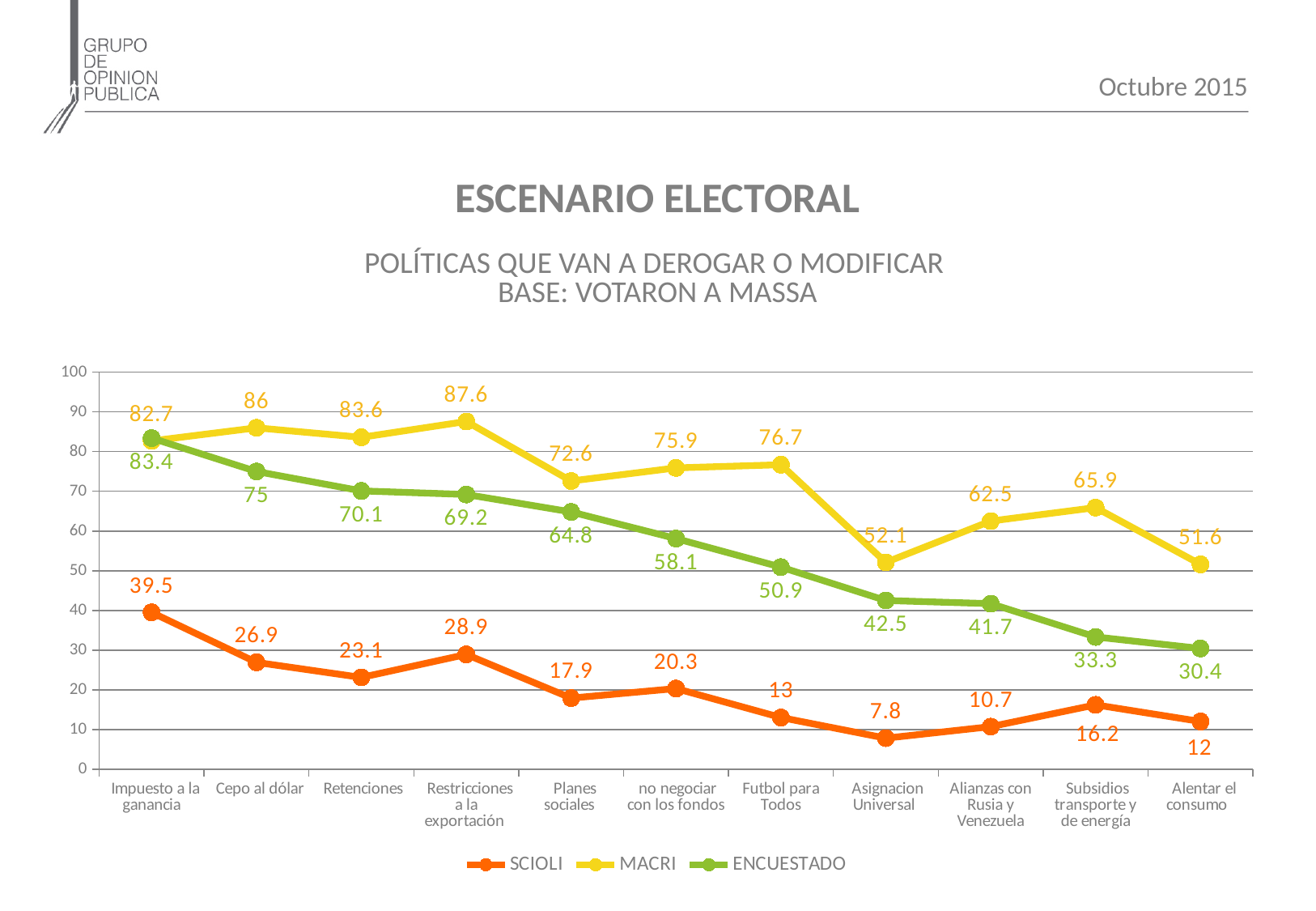
How many categories are shown on the x axis? 11 What kind of chart is shown on the slide? Line chart Does the ENCUESTADO series rise or fall from Impuesto a la ganancia to Alentar el consumo? Fall For Impuesto a la ganancia, which is larger: the MACRI value or the ENCUESTADO value? ENCUESTADO What is the MACRI value for Restricciones a la exportación? 87.6 Which category has the highest MACRI value? Restricciones a la exportación What is the ENCUESTADO value for Futbol para Todos? 50.9 Which category has the lowest SCIOLI value? Asignacion Universal Which series is drawn in green? ENCUESTADO What is the SCIOLI value for Asignacion Universal? 7.8 What is the difference between the MACRI and SCIOLI values for Cepo al dólar? 59.1 How many series does the legend list? 3